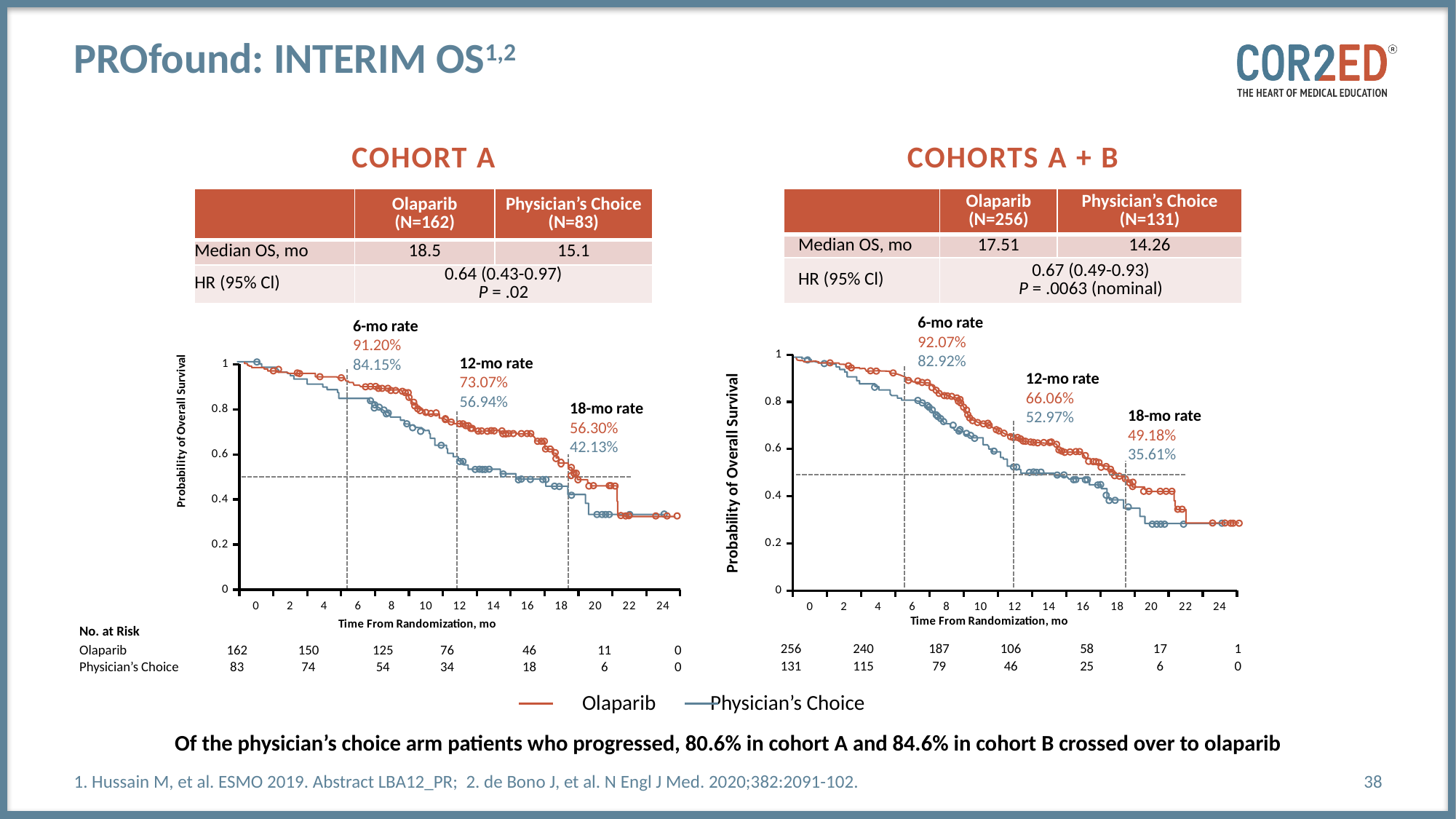
In the COHORTS A + B chart, what is the 6-mo rate for Physician's Choice? 82.92% What is the label on the y axis of the COHORTS A + B chart? Probability of Overall Survival In the COHORT A chart, what is the 6-mo rate for Olaparib? 91.20% In the COHORT A chart, how many Olaparib patients are at risk at 12 months? 76 In the COHORT A chart, which arm has the higher 12-mo rate, Olaparib or Physician's Choice? Olaparib In the COHORTS A + B chart, what is the 18-mo rate for Olaparib? 49.18% In the COHORT A chart, what is the 12-mo rate for Physician's Choice? 56.94% In the COHORT A chart, do the survival curves rise or fall as time from randomization increases? Fall In the COHORT A chart, what is the difference between the Olaparib and Physician's Choice 18-mo rates? 14.17 percentage points How many series does the legend list for the survival charts? 2 What kind of chart is shown under the COHORT A heading? Line chart (Kaplan-Meier survival curve) In the COHORTS A + B chart, what is the difference between the Olaparib and Physician's Choice 12-mo rates? 13.09 percentage points